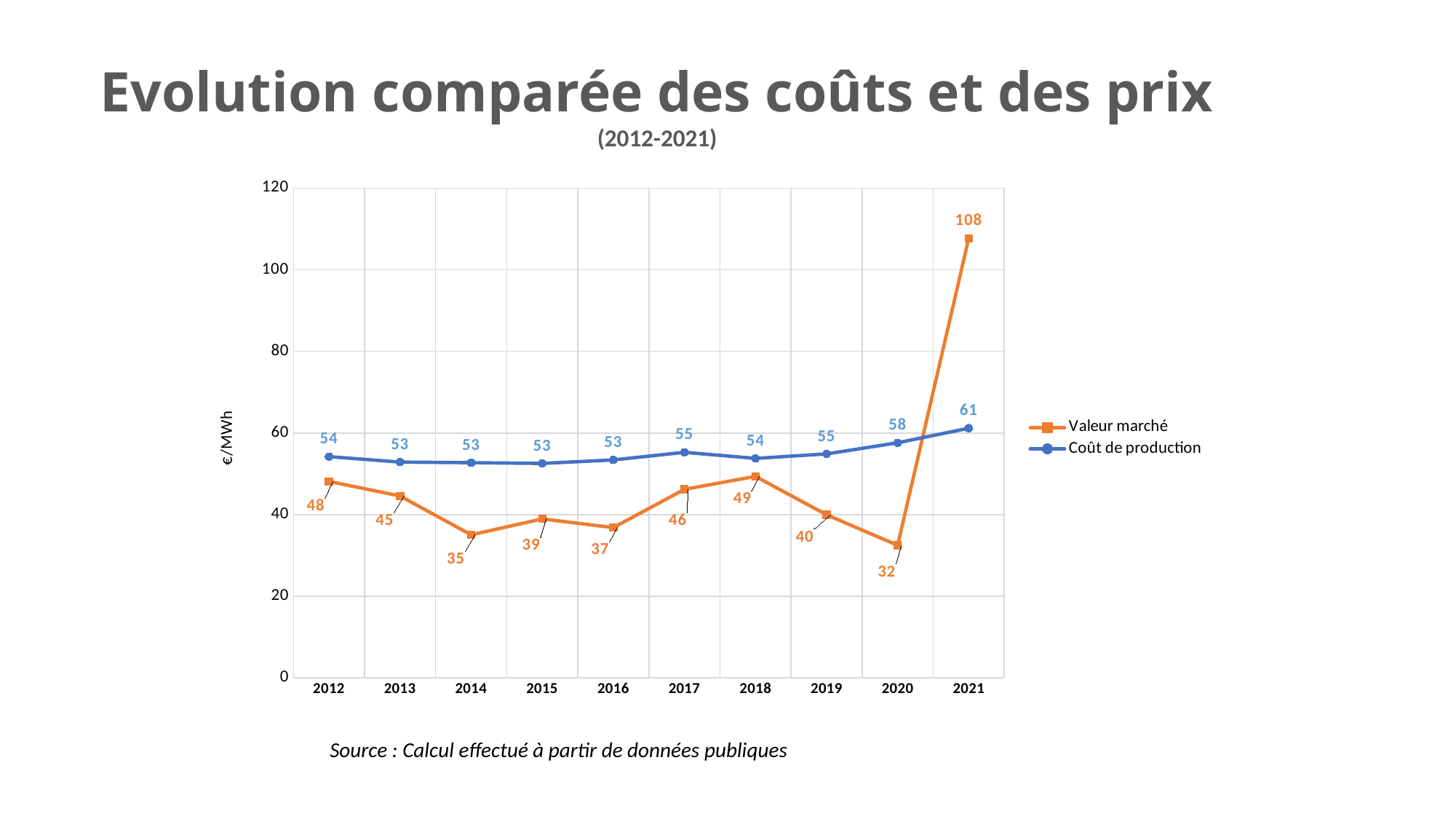
Which is larger in 2018, Valeur marché or Coût de production? Coût de production In which year is Valeur marché lowest? 2020 What is the difference between Coût de production and Valeur marché in 2020? 26 How many series does the legend list? 2 What is the Valeur marché value for 2014? 35 What unit is shown on the y axis label? €/MWh How many years are shown on the x axis? 10 What is the Coût de production value for 2020? 58 What is the Valeur marché value for 2021? 108 What kind of chart is shown on the slide? Line chart In which year is Coût de production highest? 2021 Is the Valeur marché value for 2021 greater or less than 100? greater